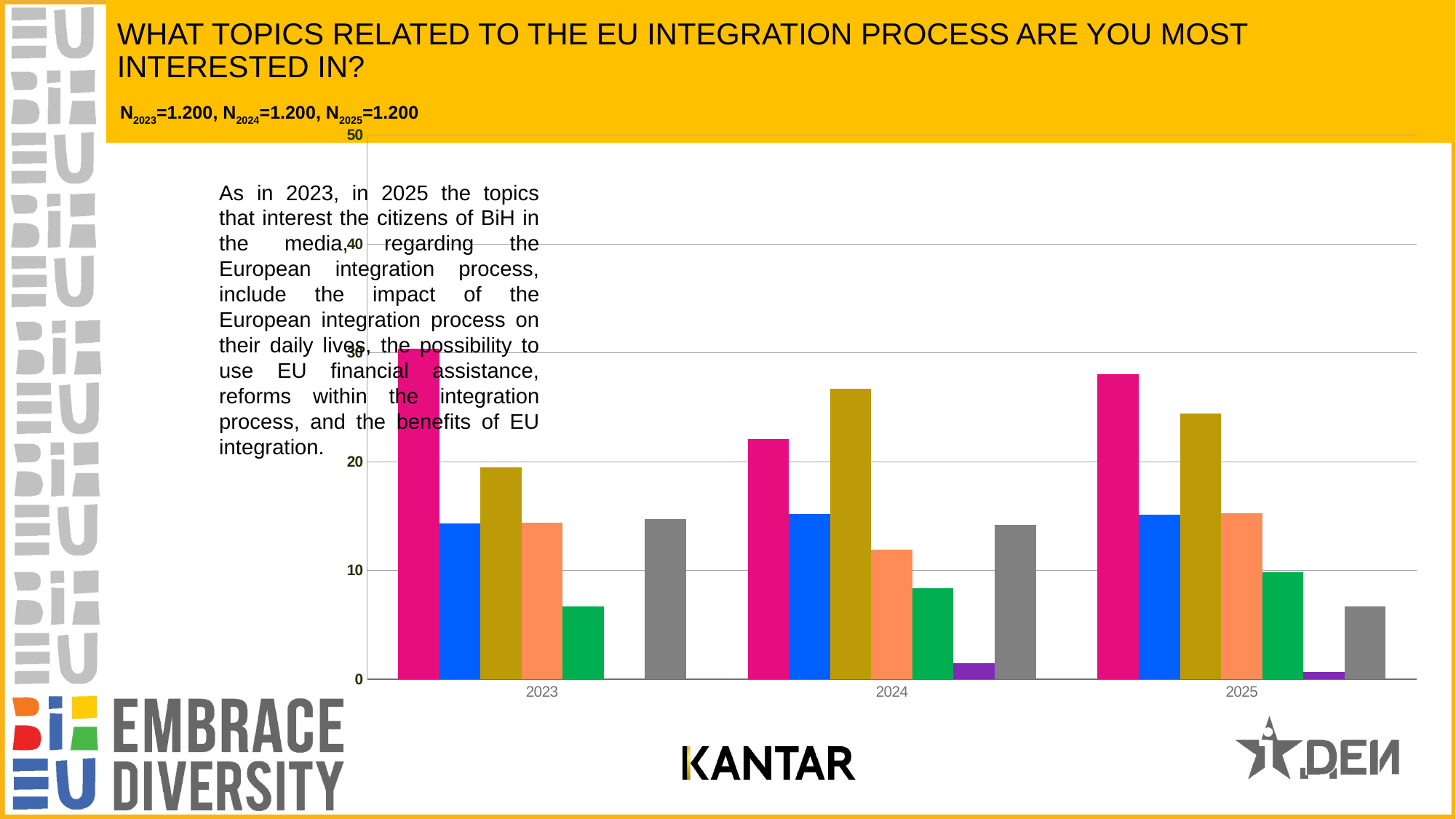
What kind of chart is shown on the slide? bar chart Is the value of the green bar for 2023 greater or less than 10? less Is the value of the gold bar for 2025 greater or less than 20? greater In the 2024 group, which coloured bar is the highest? the gold bar Which years are shown as categories on the x axis? 2023, 2024, 2025 How many year categories are shown on the x axis of the chart? 3 Which is larger: the magenta bar for 2023 or the magenta bar for 2024? the magenta bar for 2023 Do the values of the green bars rise or fall from 2023 to 2025? rise Is the value of the gray bar for 2025 greater or less than 10? less In the 2025 group, which coloured bar is the lowest? the purple bar In the 2023 group, which coloured bar is the highest? the magenta bar